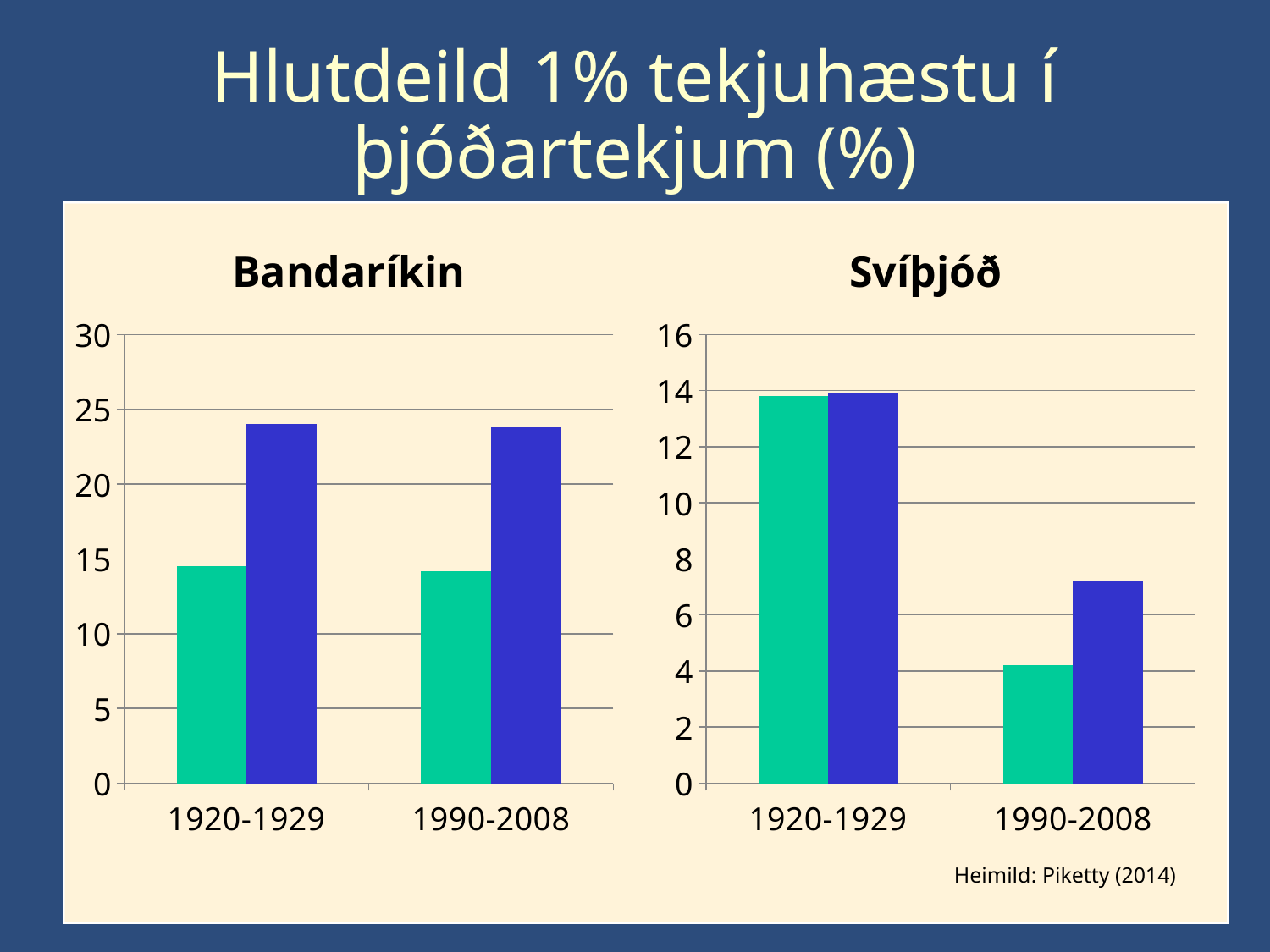
In the Bandaríkin chart, for 1920-1929, which bar is taller, the green one or the blue one? the blue one What is the title of the chart on the right side of the slide? Svíþjóð In the Svíþjóð chart, do the blue bars rise or fall from 1920-1929 to 1990-2008? fall In the Svíþjóð chart, is the value of the green bar for 1920-1929 greater or less than 12? greater In the Svíþjóð chart, is the value of the blue bar for 1990-2008 greater or less than 6? greater How many time periods are shown on the x axis of the Bandaríkin chart? 2 In the Bandaríkin chart, is the value of the green bar for 1990-2008 greater or less than 10? greater What kind of chart is the Bandaríkin chart? bar chart In the Svíþjóð chart, for 1990-2008, which bar is taller, the green one or the blue one? the blue one In the Svíþjóð chart, which period has the tallest bar? 1920-1929